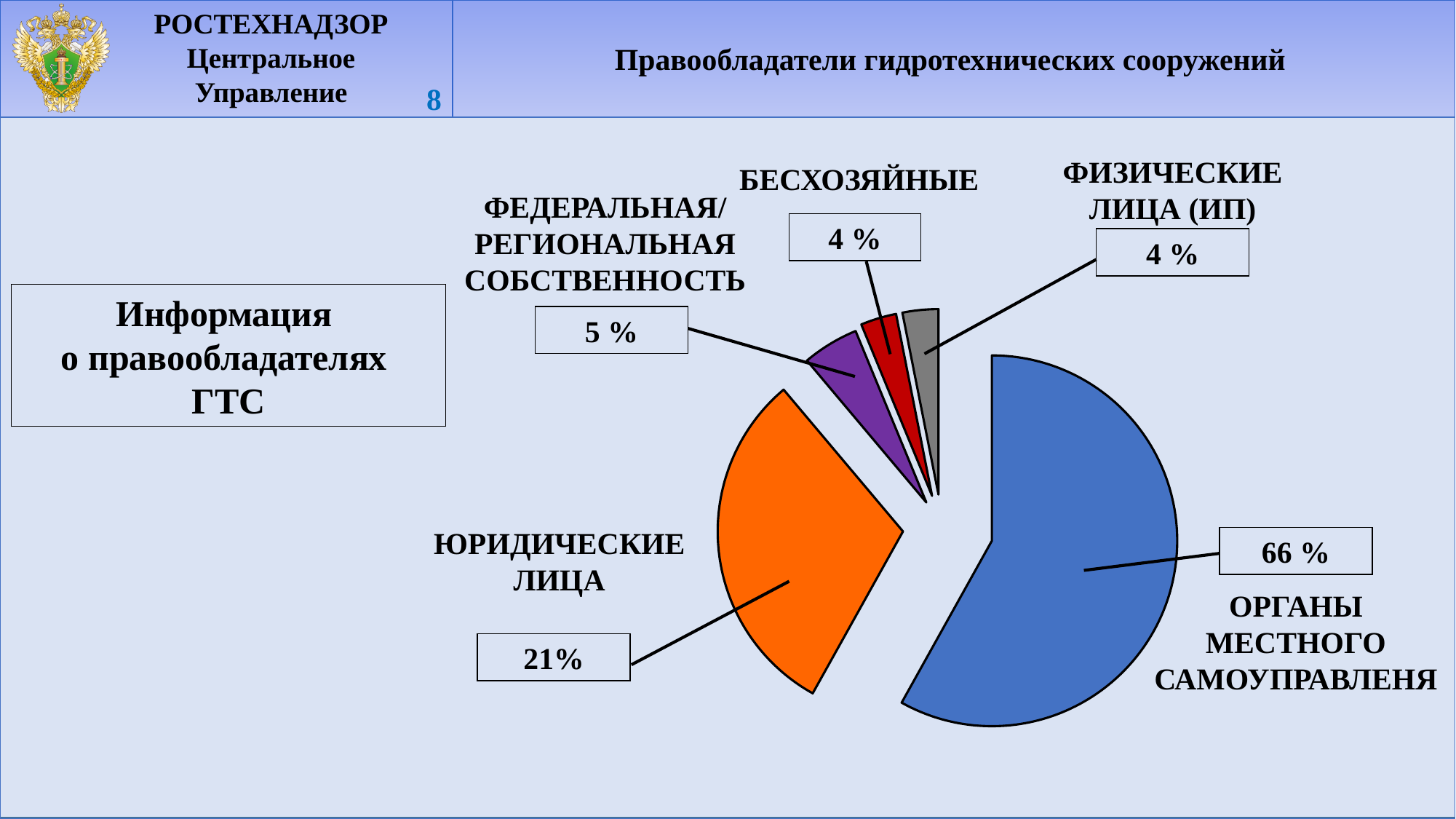
What is the difference in percentage points between ОРГАНЫ МЕСТНОГО САМОУПРАВЛЕНЯ and ЮРИДИЧЕСКИЕ ЛИЦА? 45 What type of chart is shown on the slide? pie chart Which category has the largest slice of the pie? ОРГАНЫ МЕСТНОГО САМОУПРАВЛЕНЯ Which is larger: the share for ЮРИДИЧЕСКИЕ ЛИЦА or the share for ФЕДЕРАЛЬНАЯ/РЕГИОНАЛЬНАЯ СОБСТВЕННОСТЬ? ЮРИДИЧЕСКИЕ ЛИЦА What share of the pie is labelled for ЮРИДИЧЕСКИЕ ЛИЦА? 21% What colour is the slice for ЮРИДИЧЕСКИЕ ЛИЦА? orange What share of the pie is labelled for ФЕДЕРАЛЬНАЯ/РЕГИОНАЛЬНАЯ СОБСТВЕННОСТЬ? 5 % How many slices does the pie chart have? 5 What is the title of the slide containing the pie chart? Правообладатели гидротехнических сооружений What share of the pie is labelled for ФИЗИЧЕСКИЕ ЛИЦА (ИП)? 4 % What share of the pie is labelled for ОРГАНЫ МЕСТНОГО САМОУПРАВЛЕНЯ? 66 % What share of the pie is labelled for БЕСХОЗЯЙНЫЕ? 4 %